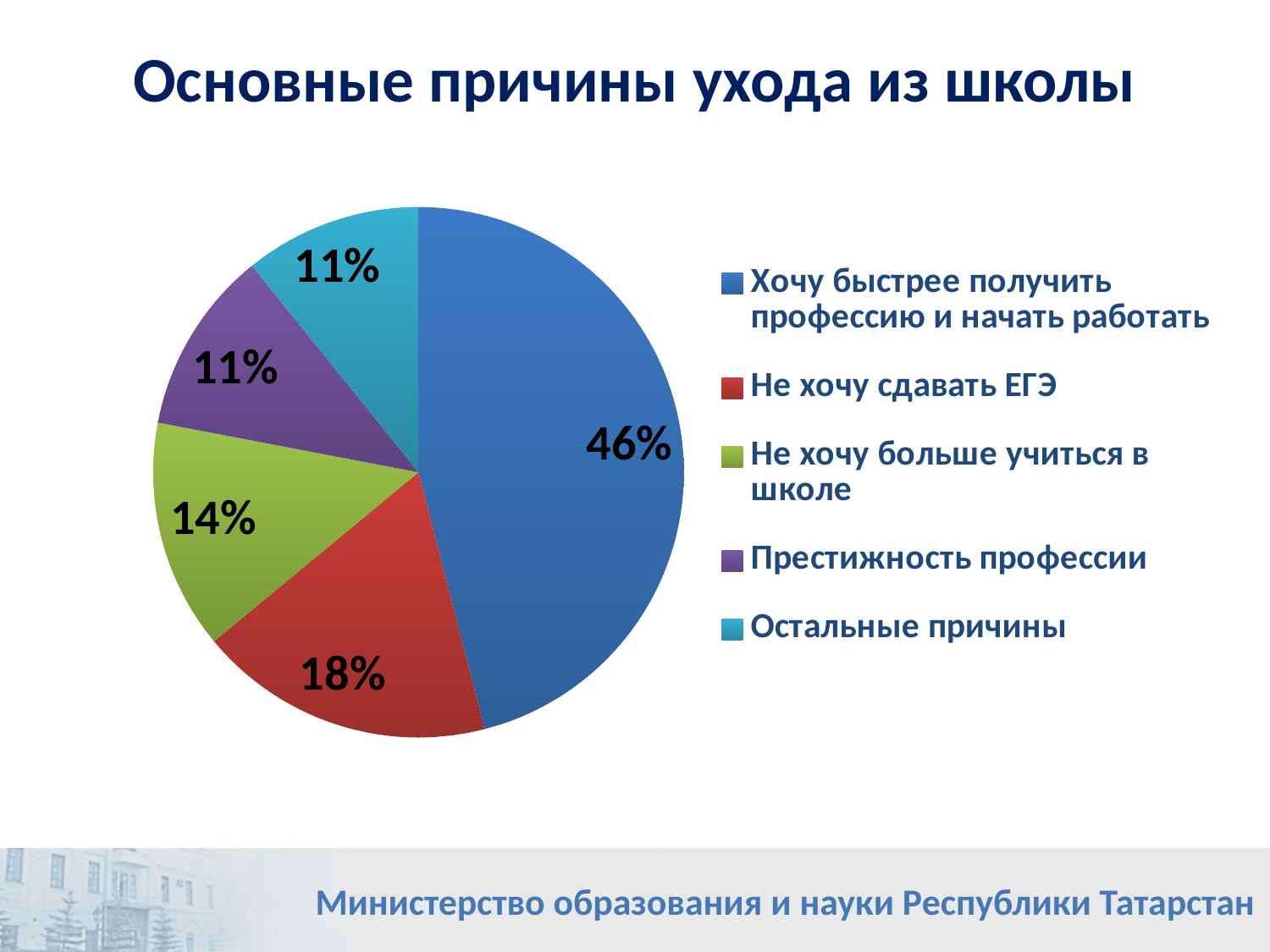
Which is larger: the share for "Не хочу больше учиться в школе" or for "Престижность профессии"? Не хочу больше учиться в школе What is the difference between the shares for "Хочу быстрее получить профессию и начать работать" and "Не хочу сдавать ЕГЭ"? 28% What is the value for "Остальные причины"? 11% How many slices does the pie chart have? 5 What share of the pie is labelled "Хочу быстрее получить профессию и начать работать"? 46% What colour is the slice for "Не хочу сдавать ЕГЭ"? red Which reason has the largest share of the pie? Хочу быстрее получить профессию и начать работать What is the title of the chart? Основные причины ухода из школы What is the value for "Престижность профессии"? 11% What is the value for "Не хочу больше учиться в школе"? 14% What kind of chart is shown on the slide? pie chart What is the value for "Не хочу сдавать ЕГЭ"? 18%